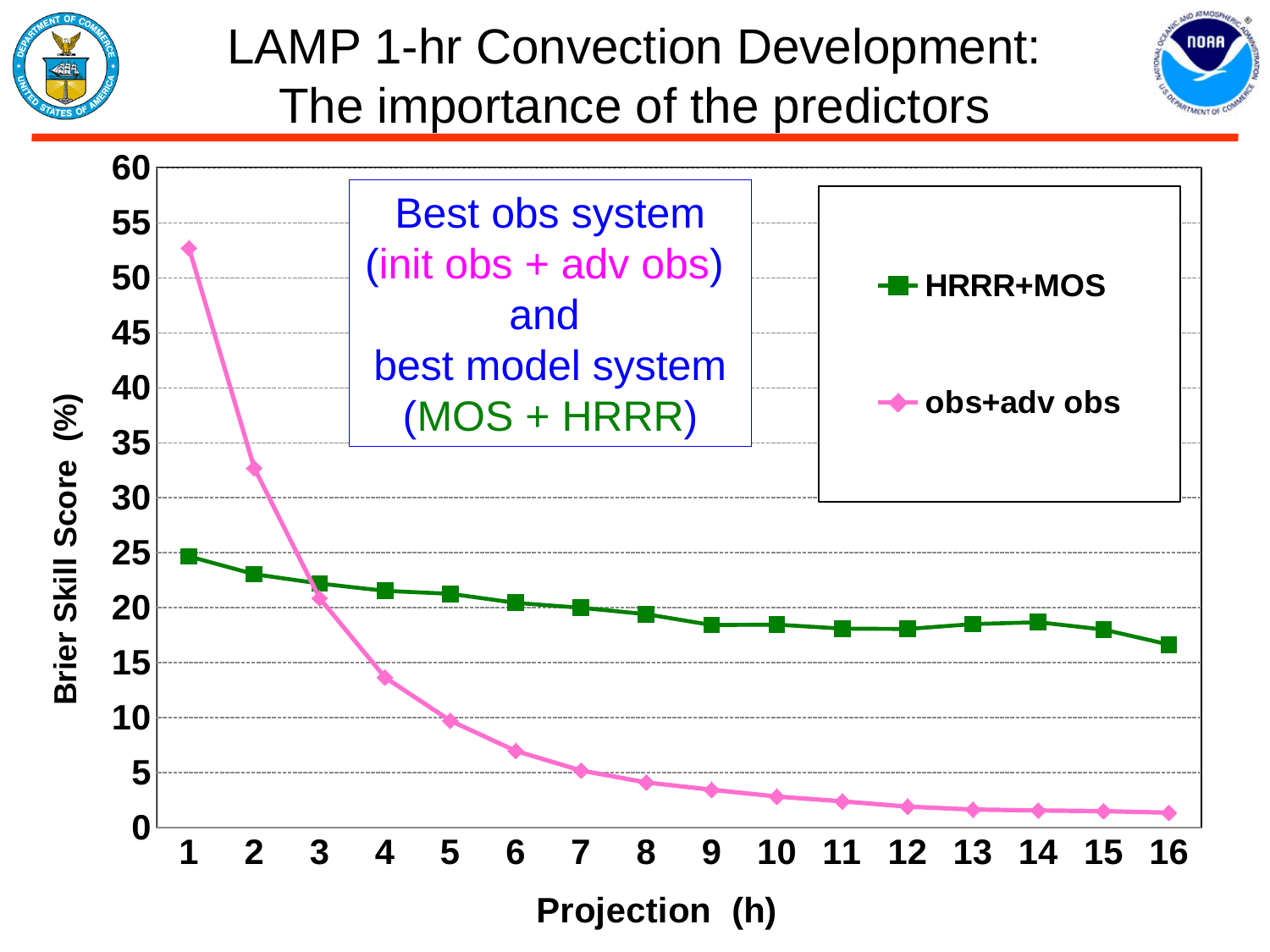
Is the value for HRRR+MOS at projection 9 greater or less than 20? less Is the value for HRRR+MOS at projection 16 greater or less than 15? greater At which projection hour does the obs+adv obs series reach its highest value? 1 At projection 1, which series has the higher Brier Skill Score? obs+adv obs What kind of chart is shown on the slide? line chart How many series does the legend list? 2 Is the value for obs+adv obs at projection 16 greater or less than 5? less Does the obs+adv obs series rise or fall as the projection hour increases? fall How many projection hours are plotted along the x axis? 16 At projection 10, which series has the higher Brier Skill Score? HRRR+MOS